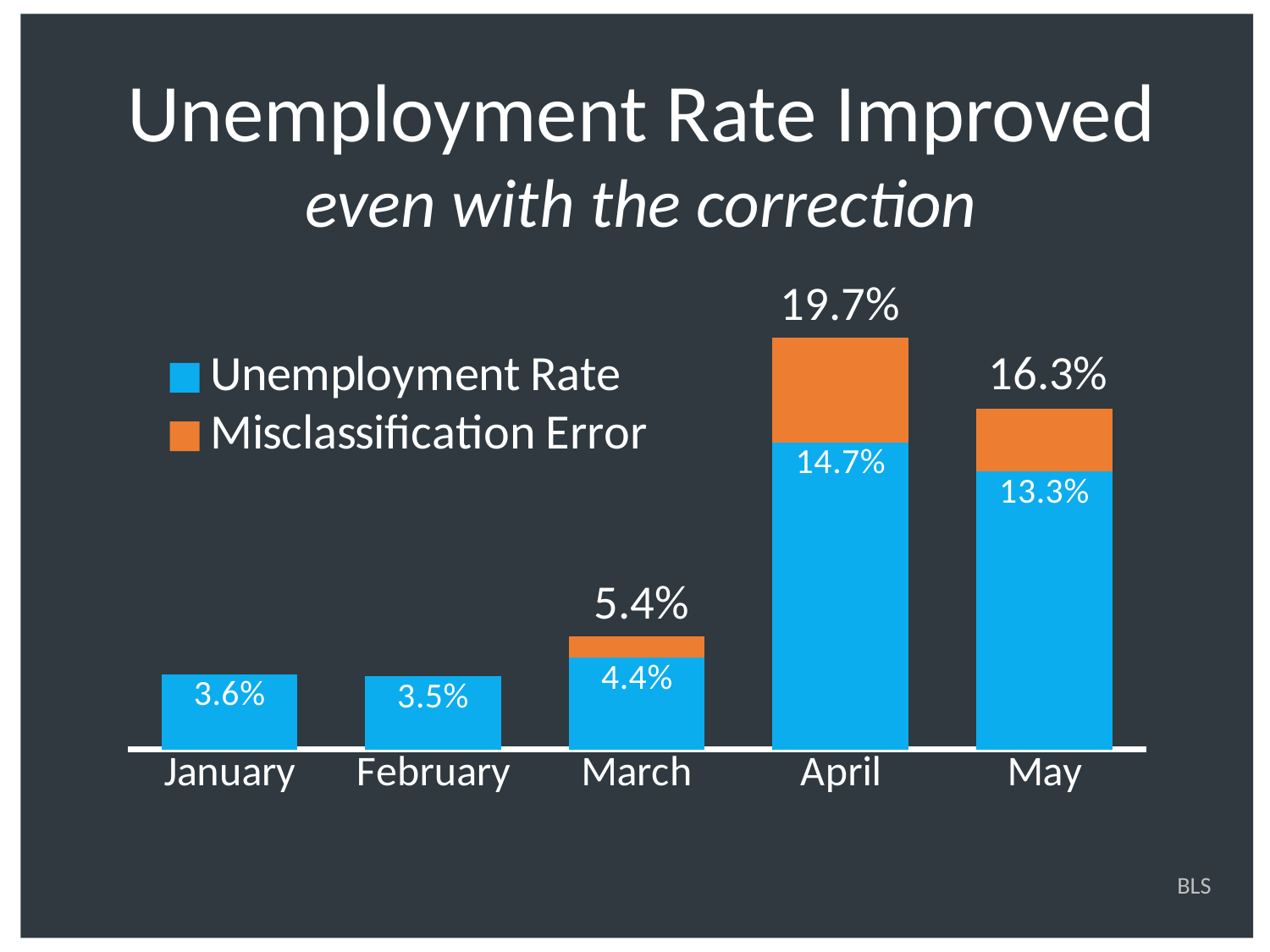
What is the Unemployment Rate for January? 3.6% What is the total height of the stacked bar for May? 16.3% What is the difference between the Unemployment Rate in April and in May? 1.4% What is the difference between the total bar for April (19.7%) and its Unemployment Rate (14.7%)? 5.0% What kind of chart is shown on the slide? Stacked bar chart How many months are shown on the x axis? 5 Which month has the highest Unemployment Rate? April What is the total height of the stacked bar for March? 5.4% How many series does the legend list? 2 Is the Unemployment Rate higher in March or in February? March Which month has the lowest Unemployment Rate? February What is the Unemployment Rate for April? 14.7%